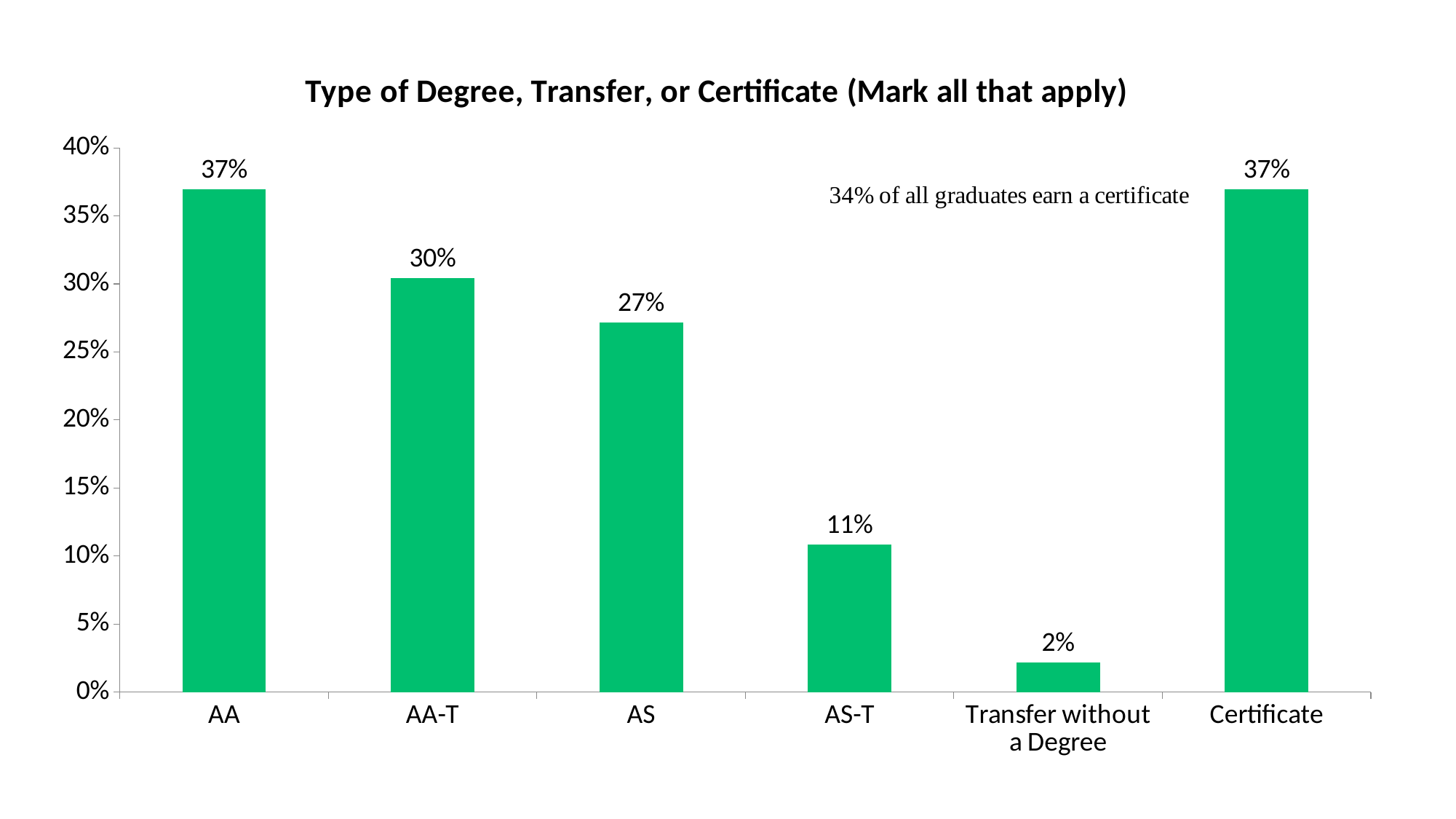
What is the value for AS-T? 11% What is the value for Transfer without a Degree? 2% What is the value for AS? 27% What is the title of the chart? Type of Degree, Transfer, or Certificate (Mark all that apply) What kind of chart is shown on the slide? Bar chart What is the difference between the values for AA-T and AS-T? 19% What is the value for Certificate? 37% Which category has the lowest value? Transfer without a Degree What is the value for AA? 37% How many categories are shown on the x axis? 6 What is the value for AA-T? 30% Which is larger, the value for AS or the value for AS-T? AS